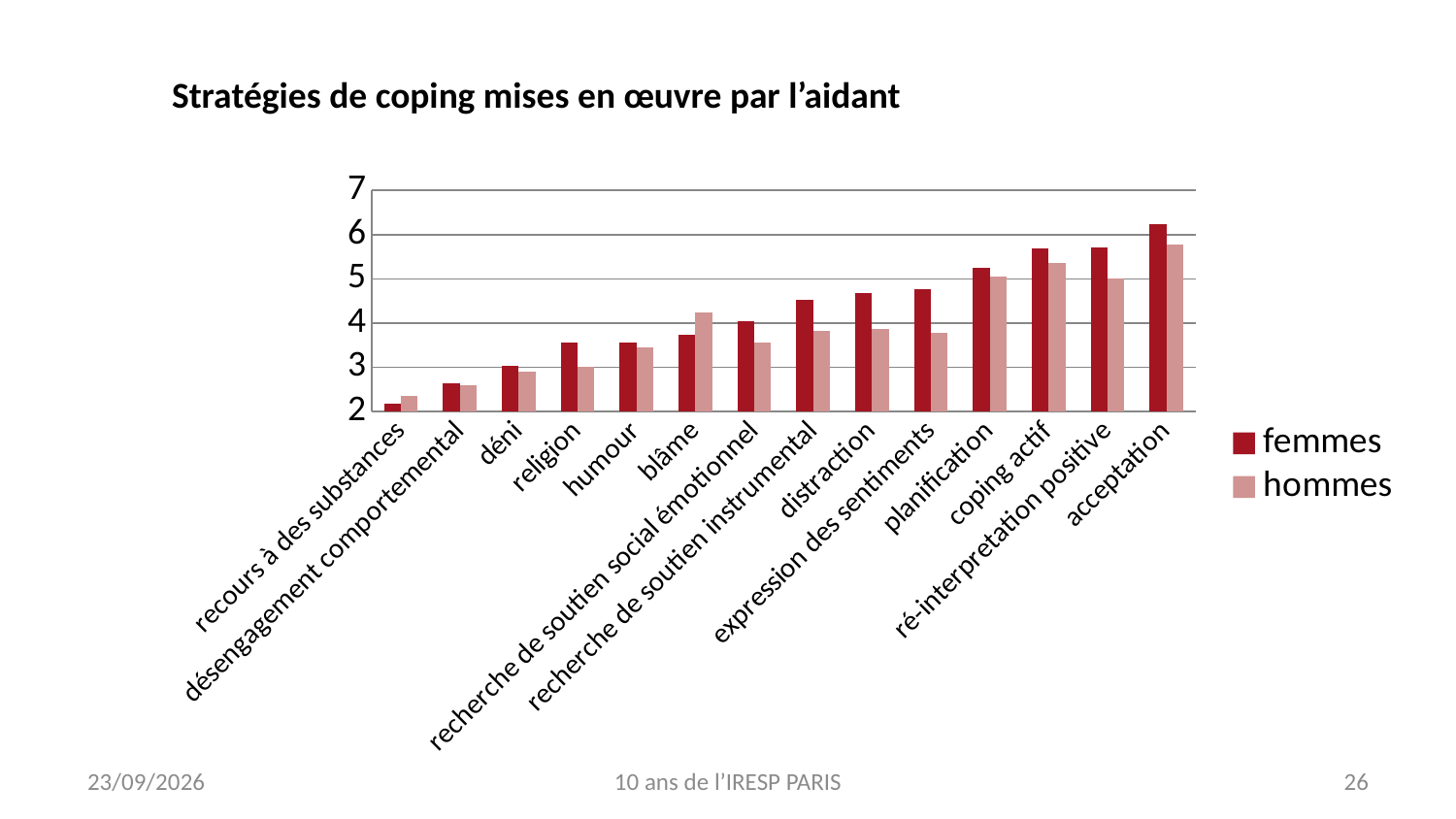
Is the value for femmes in acceptation greater or less than 6? greater What kind of chart is shown on the slide? bar chart How many series does the legend list? 2 Which category has the highest value for femmes? acceptation Which category has the lowest value for femmes? recours à des substances Is the value for hommes in blâme greater or less than 4? greater Do the femmes values rise or fall from left to right along the x axis? rise How many coping strategies (categories) are shown on the x axis? 14 Is the value for hommes in distraction greater or less than 4? less For expression des sentiments, which series has the larger value, femmes or hommes? femmes Which category has the highest value for hommes? acceptation For blâme, which series has the larger value, femmes or hommes? hommes